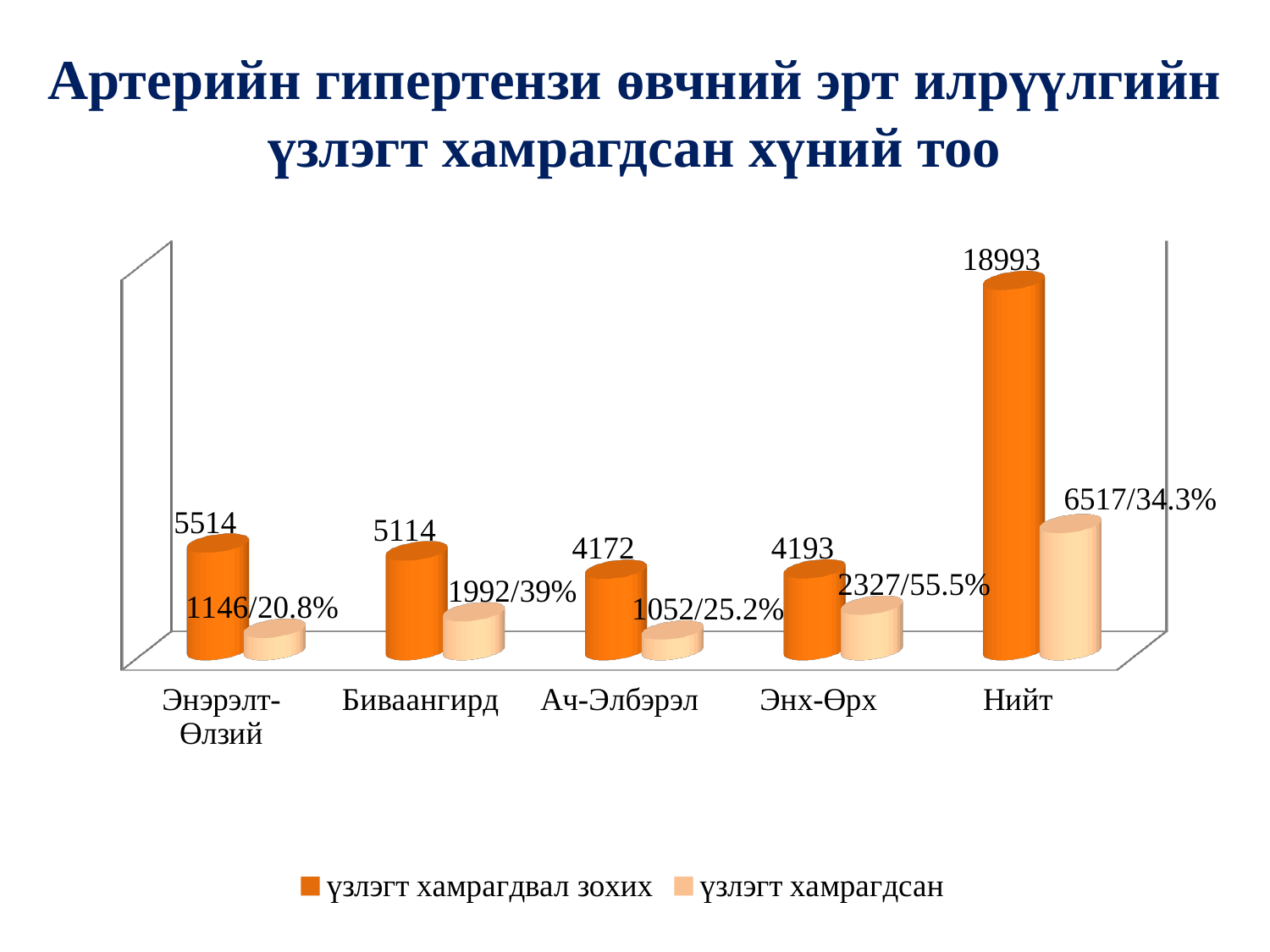
How many categories are shown on the x axis? 5 Which category has the highest value for "үзлэгт хамрагдвал зохих"? Нийт What data label is shown for "үзлэгт хамрагдсан" for Энх-Өрх? 2327/55.5% What is the value of "үзлэгт хамрагдвал зохих" for Энэрэлт-Өлзий? 5514 What kind of chart is shown on the slide? Bar chart What is the difference between the "үзлэгт хамрагдвал зохих" values for Энэрэлт-Өлзий and Биваангирд? 400 What is the value of "үзлэгт хамрагдвал зохих" for Нийт? 18993 How many series does the legend list? 2 Which is larger: the "үзлэгт хамрагдсан" count for Биваангирд or for Ач-Элбэрэл? Биваангирд Excluding Нийт, which category has the lowest value for "үзлэгт хамрагдвал зохих"? Ач-Элбэрэл Which series is shown in orange according to the legend? үзлэгт хамрагдвал зохих What data label is shown for "үзлэгт хамрагдсан" for Биваангирд? 1992/39%